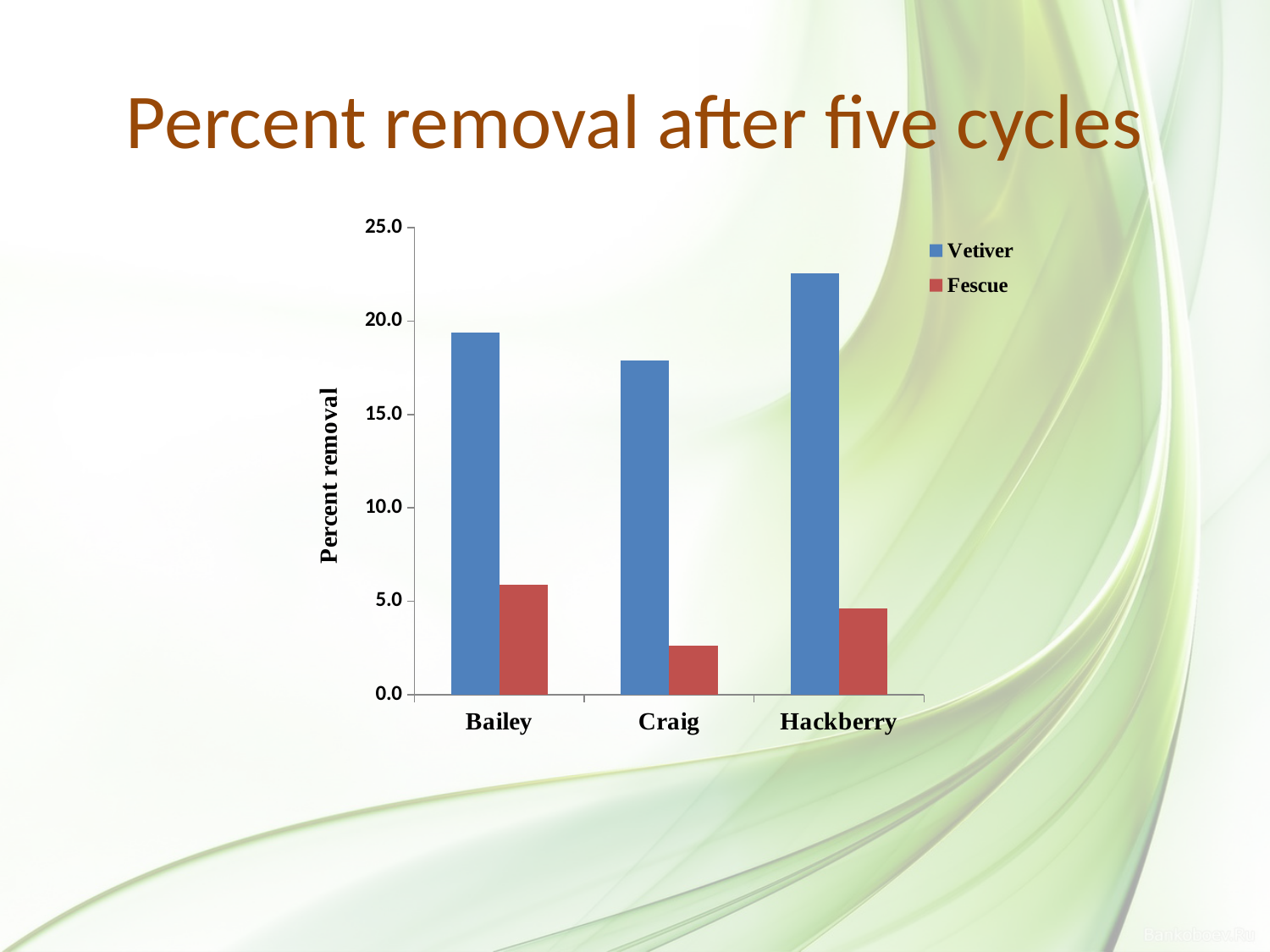
What is the title of the y axis? Percent removal Which category has the lowest Vetiver value? Craig Is the Vetiver value for Hackberry greater or less than 20.0? greater Is the Fescue value for Craig greater or less than 5.0? less What kind of chart is shown on the slide? bar chart For Hackberry, which series has the larger value, Vetiver or Fescue? Vetiver Is the Vetiver value for Craig greater or less than 15.0? greater How many categories are shown on the x axis? 3 Which category has the highest Vetiver value? Hackberry How many series does the legend list? 2 Which category has the lowest Fescue value? Craig Which category has the highest Fescue value? Bailey